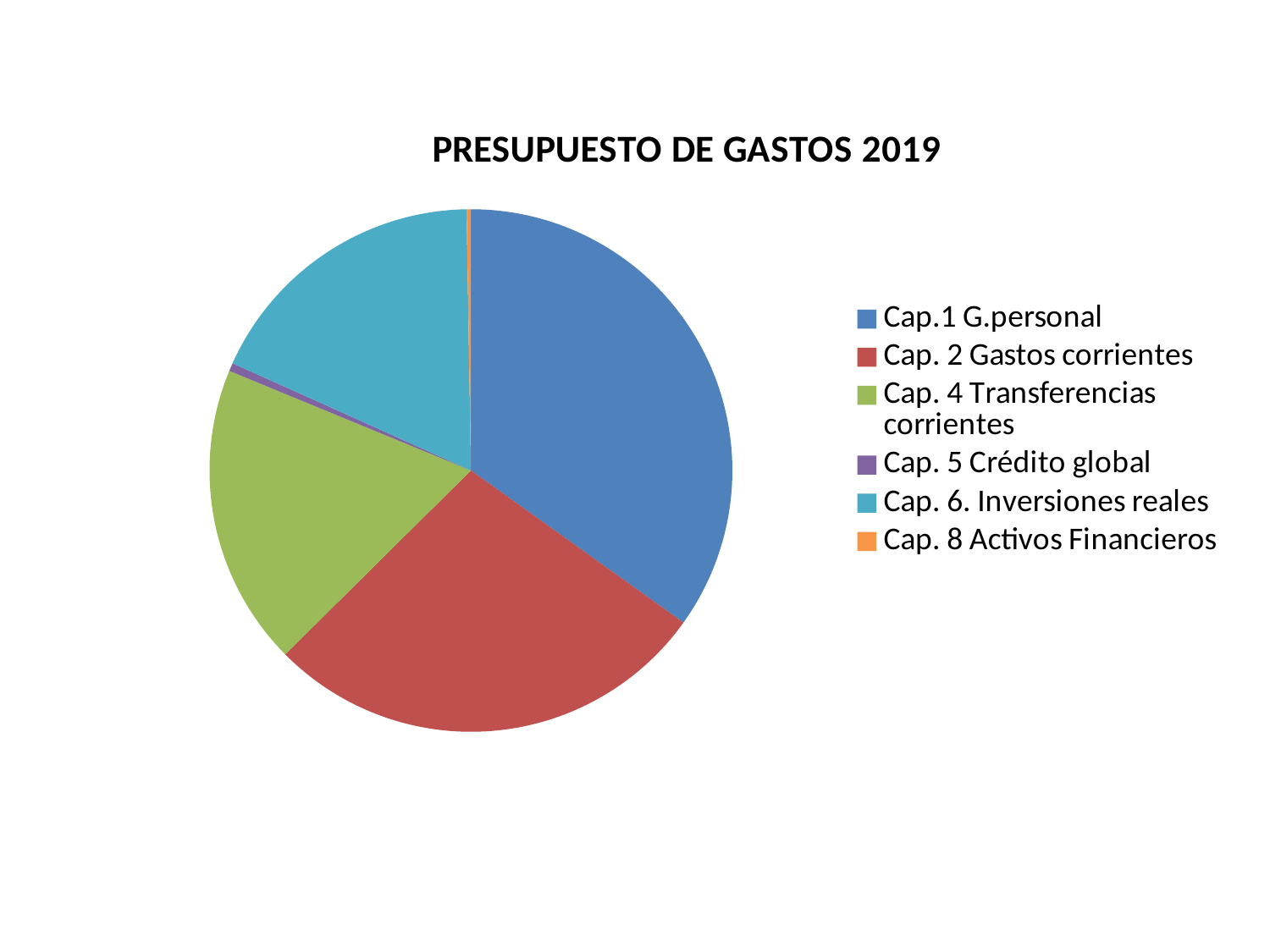
What colour is the slice for Cap. 2 Gastos corrientes? red What is the title of the chart? PRESUPUESTO DE GASTOS 2019 Which slice is larger, Cap.1 G.personal or Cap. 2 Gastos corrientes? Cap.1 G.personal What kind of chart is shown on the slide? pie chart Which category is shown in green in the pie chart? Cap. 4 Transferencias corrientes Which slice is larger, Cap. 4 Transferencias corrientes or Cap. 5 Crédito global? Cap. 4 Transferencias corrientes Which category has the largest slice of the pie? Cap.1 G.personal Which slice is larger, Cap. 6. Inversiones reales or Cap. 8 Activos Financieros? Cap. 6. Inversiones reales How many categories does the legend of the pie chart list? 6